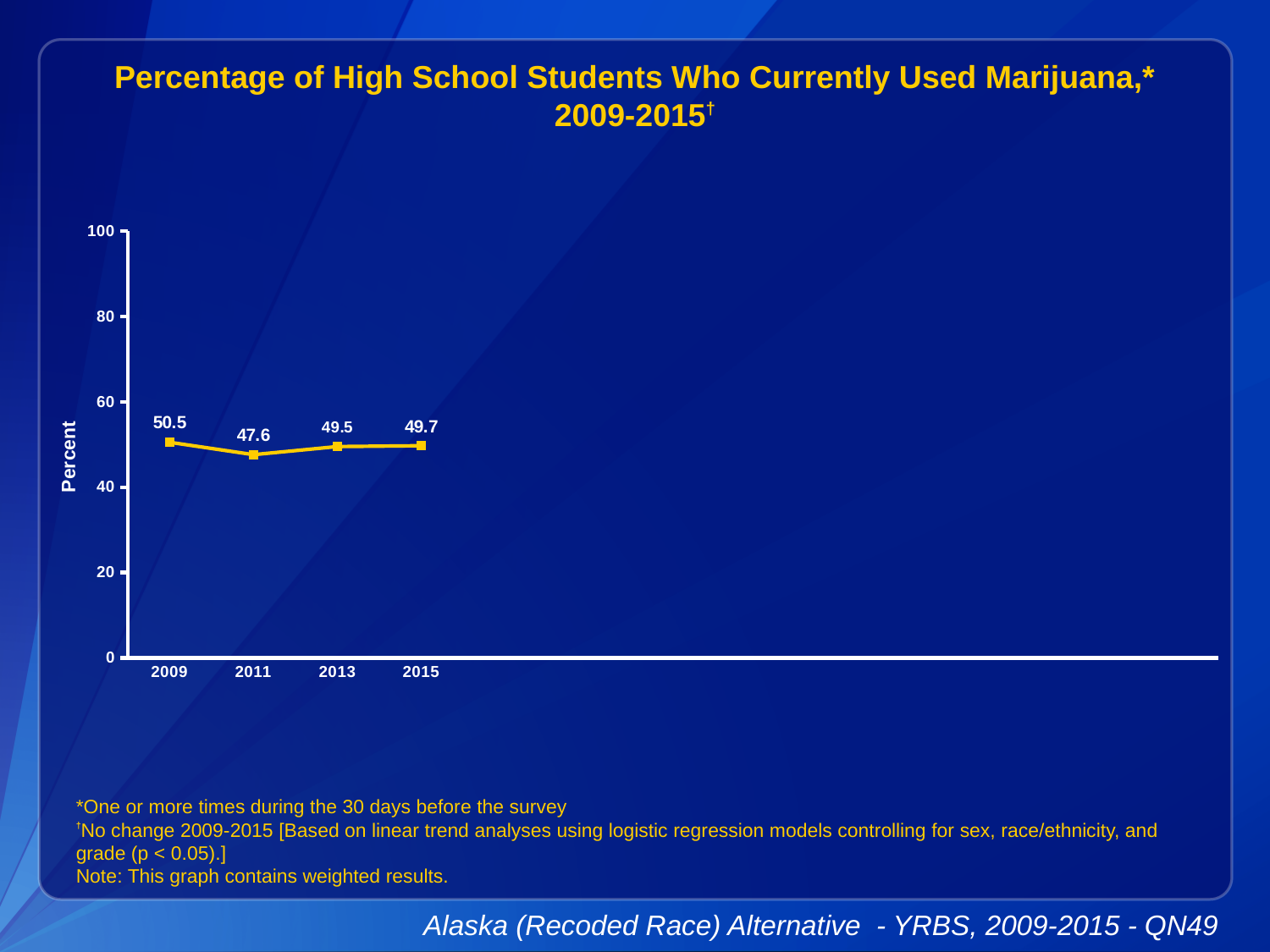
Is the value for 2011 greater or less than 60? less What is the percentage of high school students who currently used marijuana in 2009? 50.5 What is the percentage of high school students who currently used marijuana in 2015? 49.7 What is the difference between the 2009 and 2011 values? 2.9 What kind of chart is shown on the slide? line chart Which year has the highest percentage of students who currently used marijuana? 2009 What is the label on the vertical axis of the chart? Percent Which year has the lowest percentage of students who currently used marijuana? 2011 What is the percentage of high school students who currently used marijuana in 2011? 47.6 How many years are plotted on the chart? 4 Is the value for 2009 greater or less than the value for 2015? greater What is the percentage of high school students who currently used marijuana in 2013? 49.5